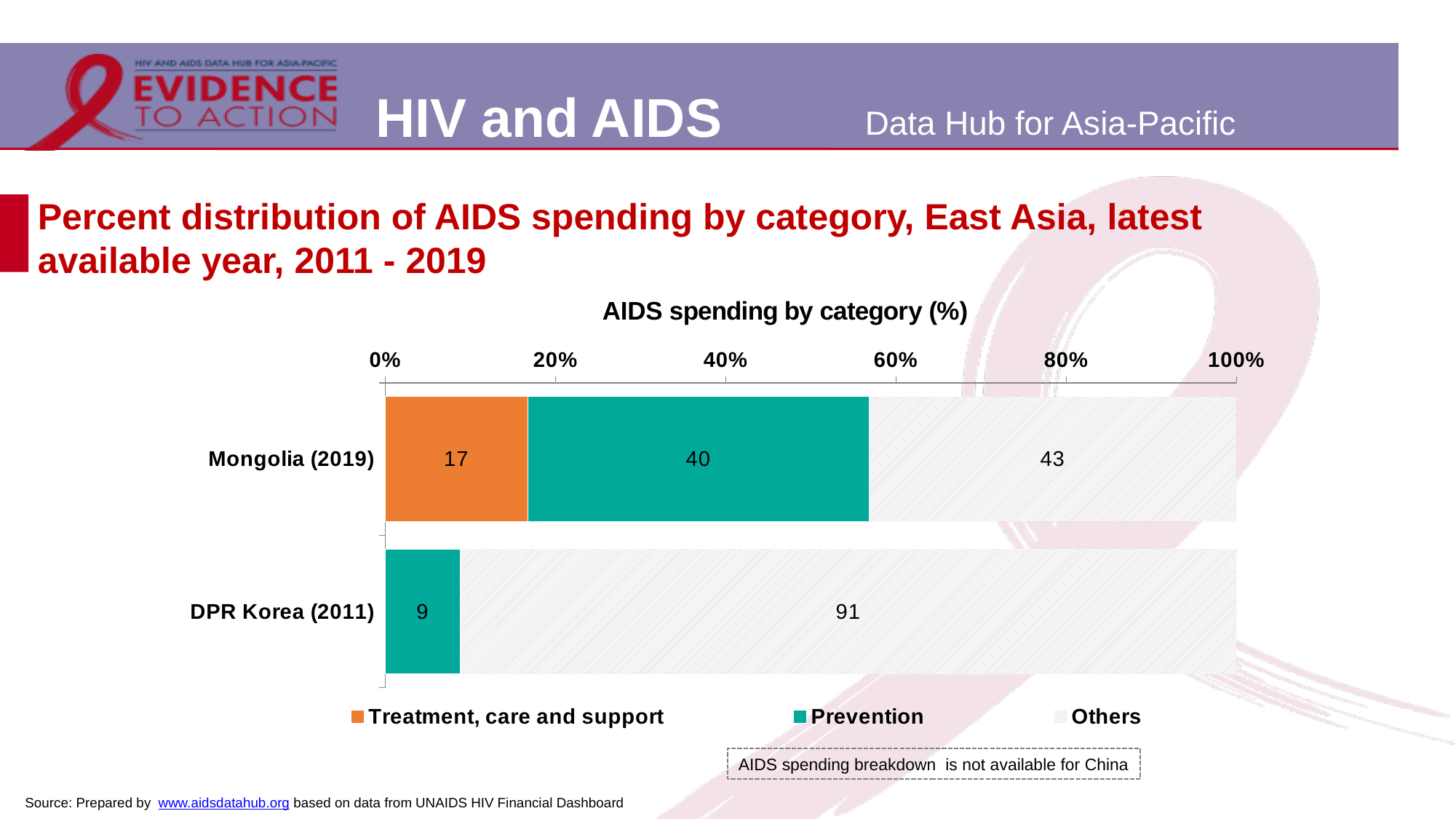
What is the Prevention value for Mongolia (2019)? 40 What is the Others value for DPR Korea (2011)? 91 What is the title of the chart? AIDS spending by category (%) Which country has the higher Prevention value? Mongolia (2019) What is the difference between the Prevention and Treatment, care and support values for Mongolia (2019)? 23 How many countries are shown in the chart? 2 What is the Prevention value for DPR Korea (2011)? 9 How many series does the legend list? 3 What is the difference between the Others values for DPR Korea (2011) and Mongolia (2019)? 48 What kind of chart is shown? Stacked bar chart What is the total of the stacked bar for Mongolia (2019)? 100 What is the Treatment, care and support value for Mongolia (2019)? 17